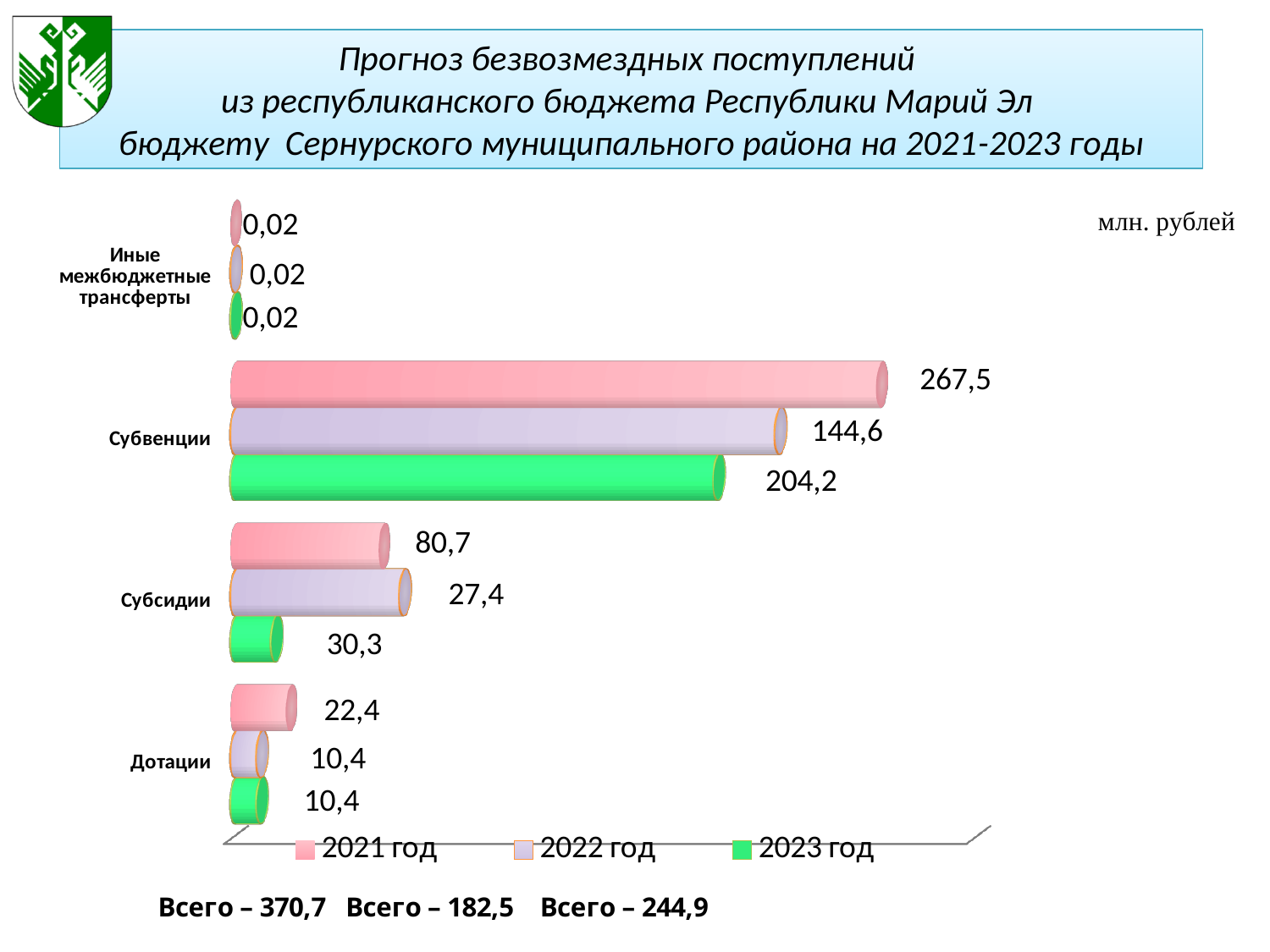
How many series does the legend list? 3 Which category has the lowest value in 2022 год? Иные межбюджетные трансферты What is the difference between the 2021 год and 2022 год values for Субвенции? 122,9 What kind of chart is shown on the slide? Bar chart Which is larger for Субсидии: the 2021 год value or the 2023 год value? 2021 год What is the value for Дотации in 2022 год? 10,4 What is the value for Субсидии in 2023 год? 30,3 Which category has the highest value in 2023 год? Субвенции How many categories are shown on the chart? 4 What is the value for Субвенции in 2021 год? 267,5 Which colour represents 2023 год in the legend? Green What is the value for Иные межбюджетные трансферты in 2021 год? 0,02